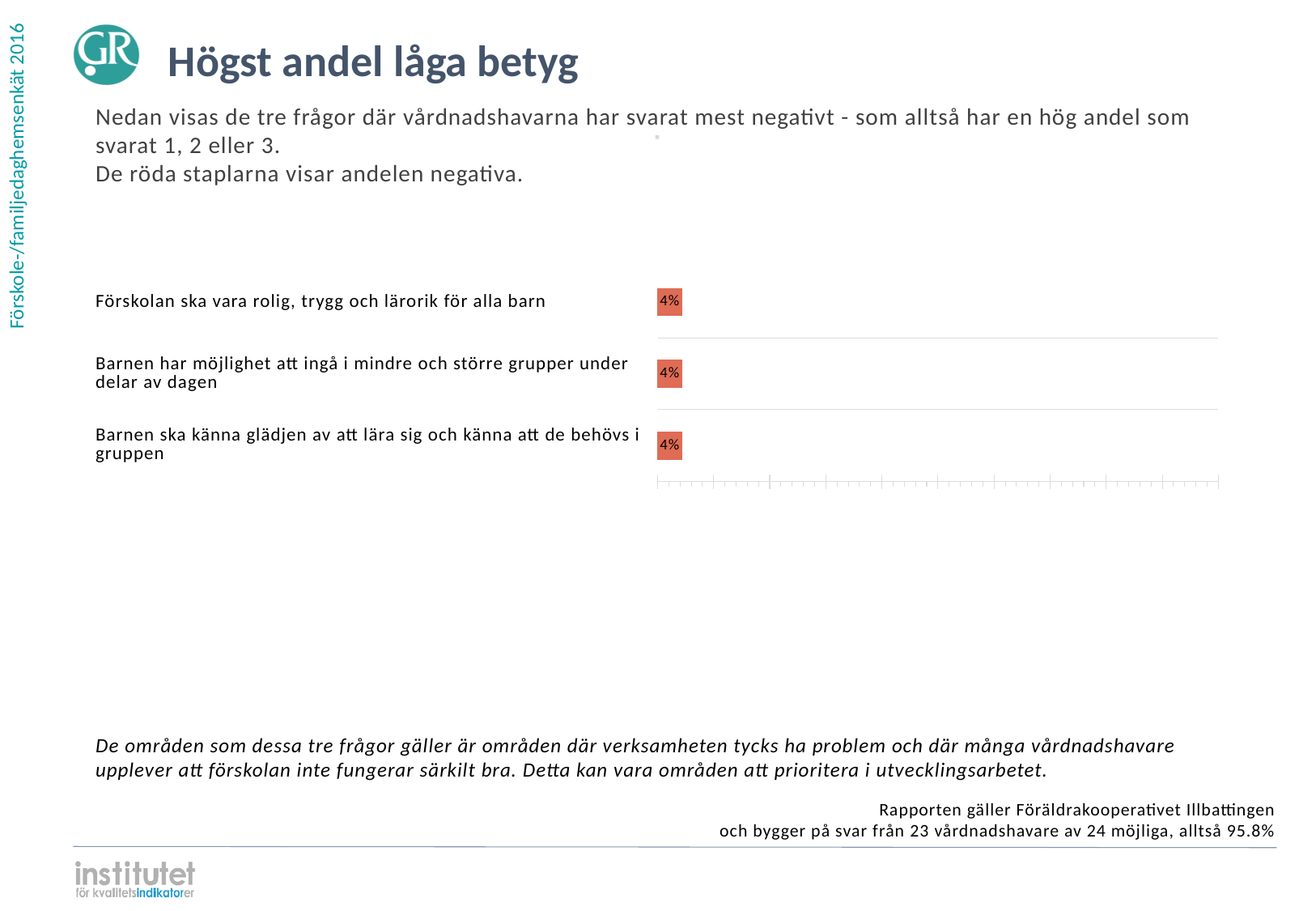
What kind of chart is shown on the slide? bar chart What is the difference between the value for "Förskolan ska vara rolig, trygg och lärorik för alla barn" and the value for "Barnen ska känna glädjen av att lära sig och känna att de behövs i gruppen"? 0% What is the value shown for "Barnen har möjlighet att ingå i mindre och större grupper under delar av dagen"? 4% How many categories (questions) are plotted in the chart? 3 Do all three bars in the chart show the same value? Yes, 4% What is the value shown for "Förskolan ska vara rolig, trygg och lärorik för alla barn"? 4% What is the title of the slide containing the chart? Högst andel låga betyg What is the value shown for "Barnen ska känna glädjen av att lära sig och känna att de behövs i gruppen"? 4% What colour are the bars in the chart? Red